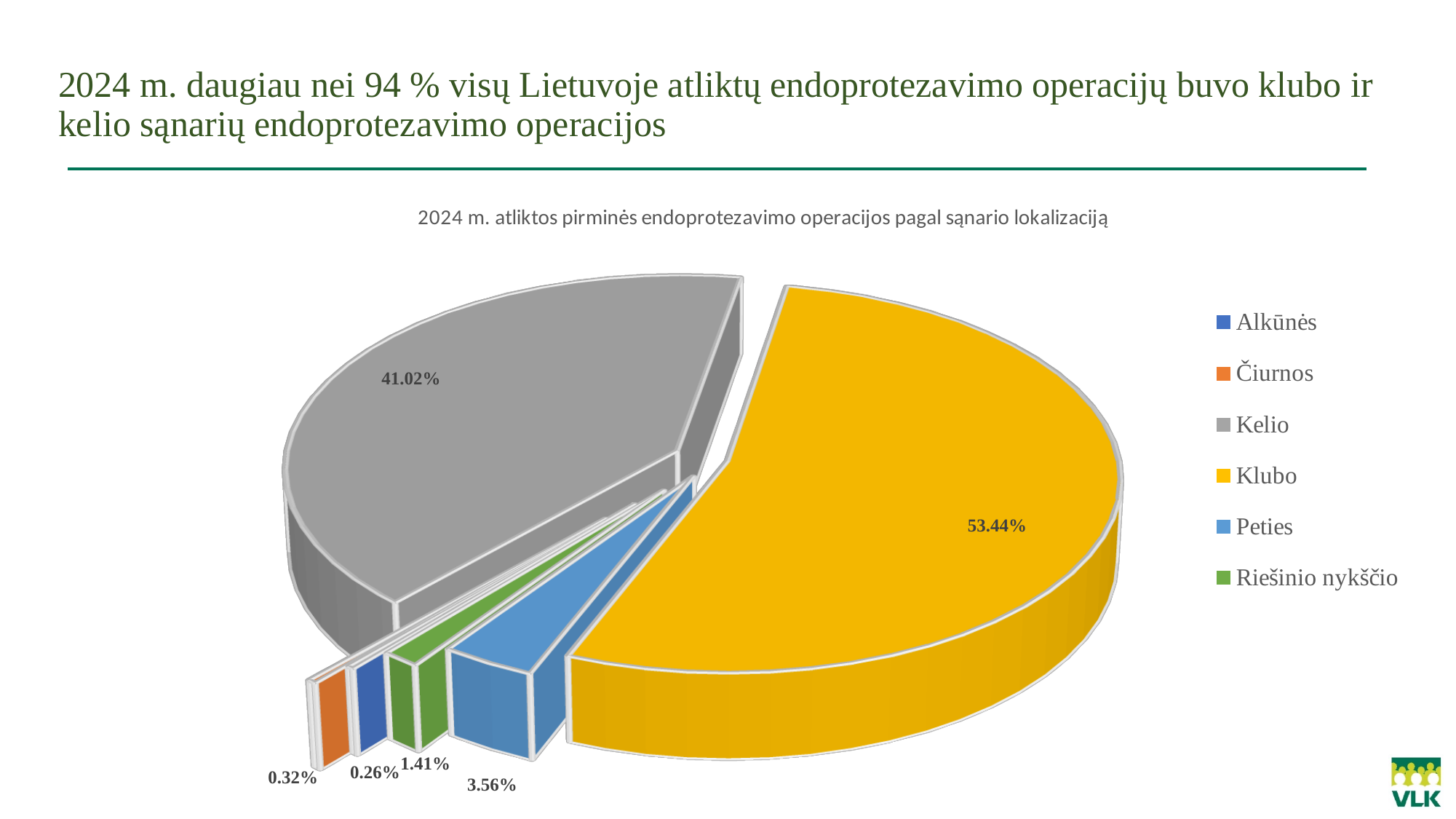
Which category has the smallest share of the pie? Alkūnės Which category has the largest share of the pie? Klubo What is the value for Riešinio nykščio? 1.41% What kind of chart is shown on the slide? Pie chart What share of the pie does Klubo have? 53.44% What is the value for Alkūnės? 0.26% What is the value for Čiurnos? 0.32% What is the title of the chart? 2024 m. atliktos pirminės endoprotezavimo operacijos pagal sąnario lokalizaciją What is the value for Peties? 3.56% How many categories does the legend list? 6 What is the difference between the shares of Klubo and Kelio? 12.42% What share of the pie does Kelio have? 41.02%